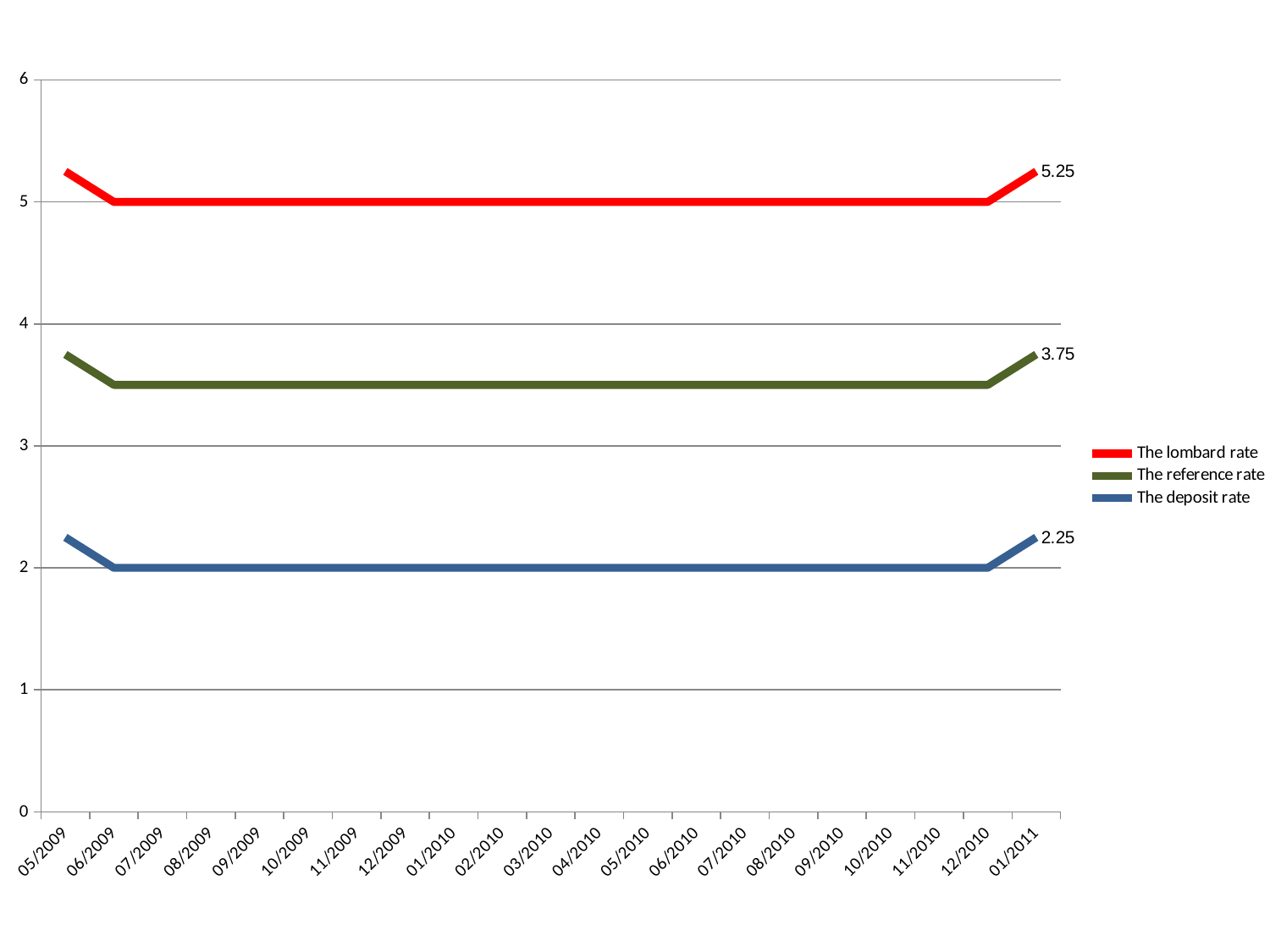
Between 06/2009 and 12/2010, does the lombard rate rise, fall, or stay flat? stays flat Which series has the lowest value at 01/2011? The deposit rate What is the value of the lombard rate at 01/2011? 5.25 What is the value of the deposit rate at 03/2010? 2 What type of chart is shown on the slide? line chart Is the value of the reference rate at 09/2010 greater or less than 4? less Which series has the highest value at 01/2011? The lombard rate What is the difference between the lombard rate and the deposit rate at 01/2011? 3 What is the value of the lombard rate at 06/2010? 5 What is the value of the deposit rate at 01/2011? 2.25 What is the value of the reference rate at 01/2011? 3.75 How many series does the legend list? 3